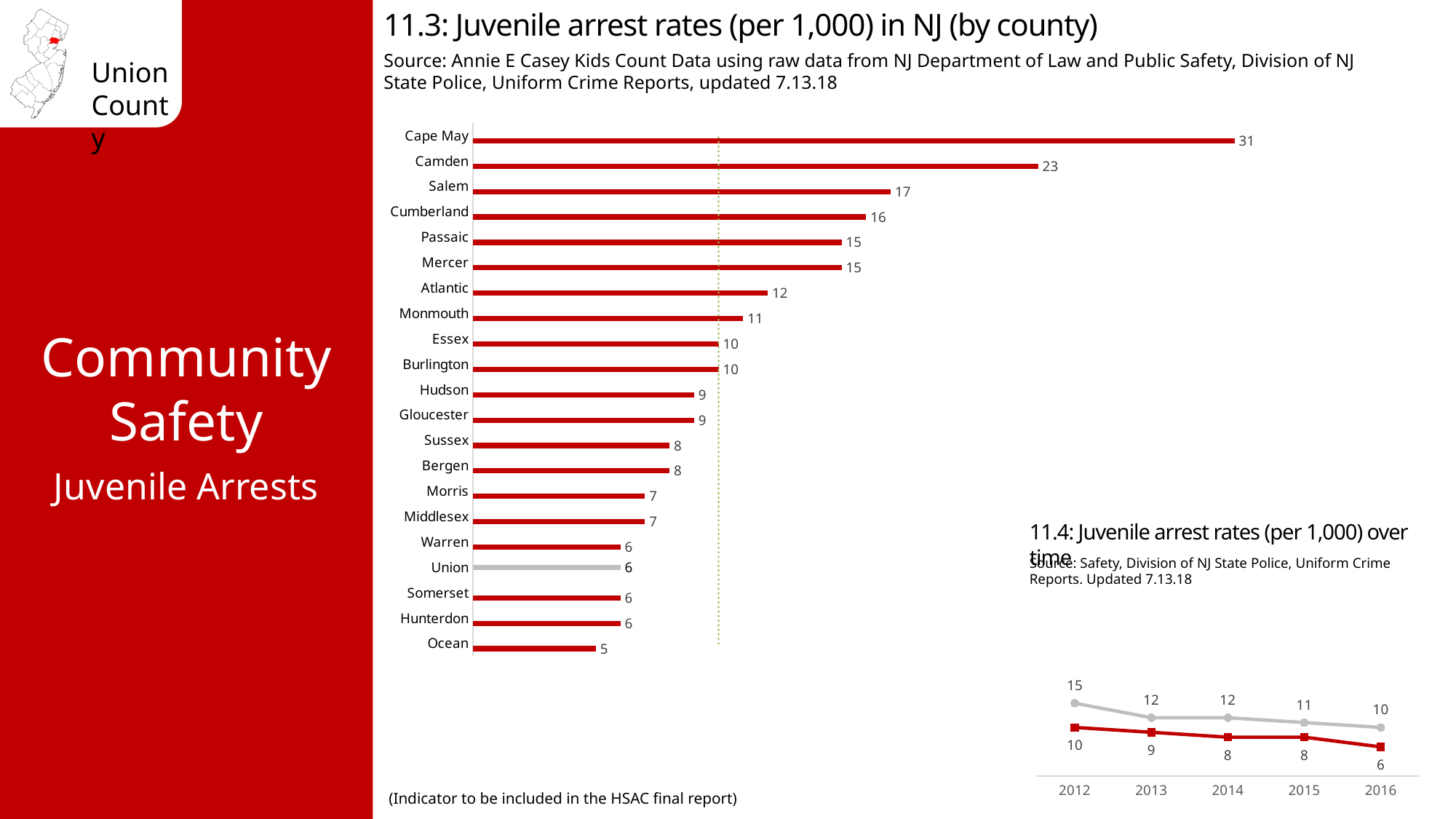
In the chart '11.3: Juvenile arrest rates (per 1,000) in NJ (by county)', which has a larger value, Atlantic or Monmouth? Atlantic How many counties are shown in the chart '11.3: Juvenile arrest rates (per 1,000) in NJ (by county)'? 21 In the chart '11.4: Juvenile arrest rates (per 1,000) over time', what is the value of the red line in 2016? 6 In the chart '11.4: Juvenile arrest rates (per 1,000) over time', what is the value of the gray line in 2012? 15 In the chart '11.3: Juvenile arrest rates (per 1,000) in NJ (by county)', which county has the lowest value? Ocean In the chart '11.4: Juvenile arrest rates (per 1,000) over time', does the red line rise or fall from 2012 to 2016? Fall In the chart '11.3: Juvenile arrest rates (per 1,000) in NJ (by county)', what is the value for Cape May? 31 In the chart '11.3: Juvenile arrest rates (per 1,000) in NJ (by county)', which county has the highest value? Cape May In the chart '11.3: Juvenile arrest rates (per 1,000) in NJ (by county)', what is the difference between the values for Camden and Salem? 6 In the chart '11.3: Juvenile arrest rates (per 1,000) in NJ (by county)', what is the value for Union? 6 What kind of chart is '11.3: Juvenile arrest rates (per 1,000) in NJ (by county)'? Bar chart In the chart '11.3: Juvenile arrest rates (per 1,000) in NJ (by county)', which county's bar is coloured gray instead of red? Union